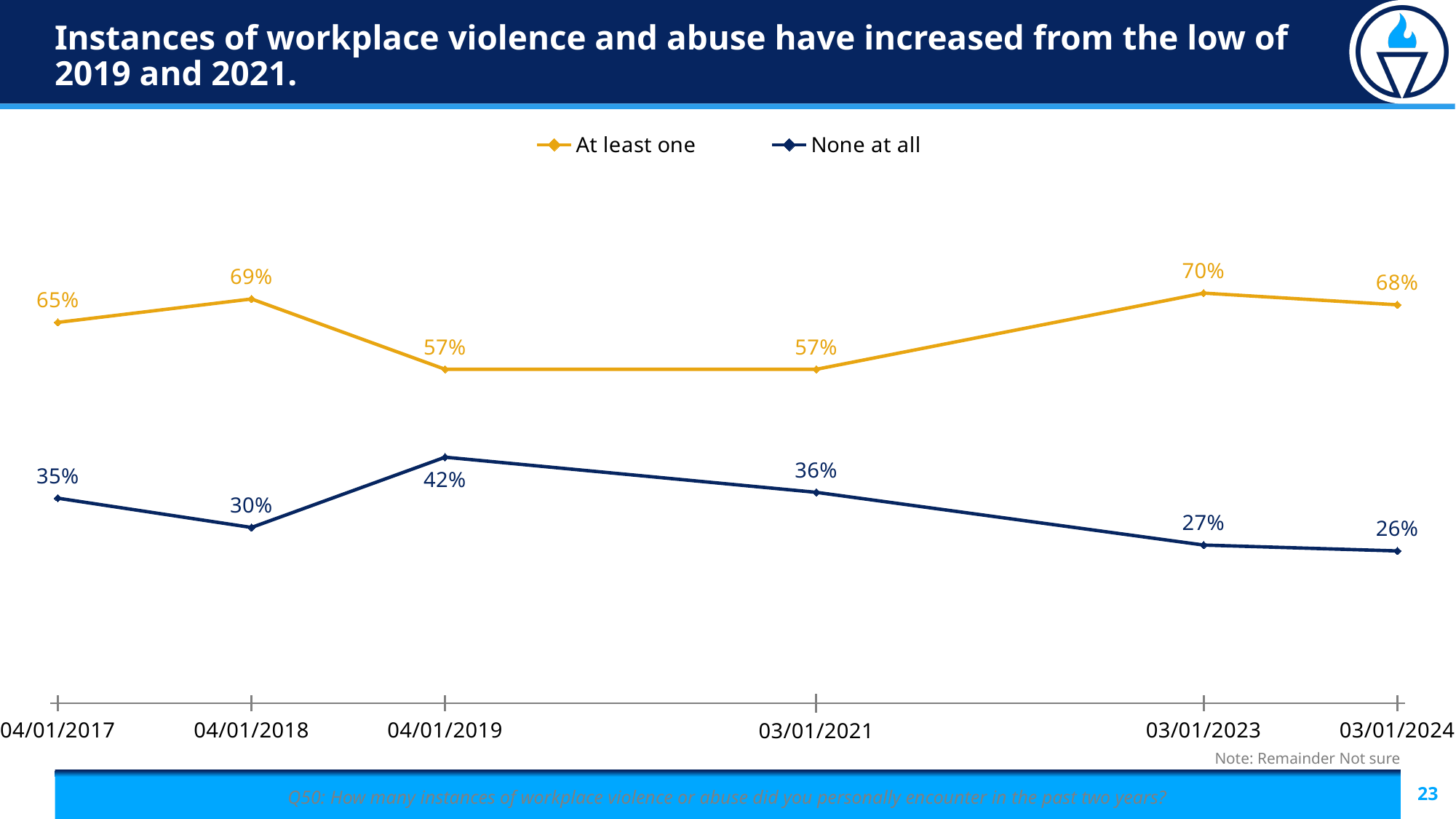
How many dates are plotted on the x axis? 6 What is the value for "None at all" at 04/01/2019? 42% Does the "None at all" series rise or fall from 03/01/2021 to 03/01/2024? Fall At which date is the "At least one" series highest? 03/01/2023 How many series does the legend list? 2 At which date is the "None at all" series lowest? 03/01/2024 What is the value for "At least one" at 03/01/2024? 68% What is the value for "At least one" at 04/01/2018? 69% Which series has the larger value at 03/01/2021, "At least one" or "None at all"? At least one Which colour is used for the "At least one" series? Yellow/gold What kind of chart is shown on the slide? Line chart What is the difference between the "At least one" value at 03/01/2023 and at 04/01/2019? 13 percentage points